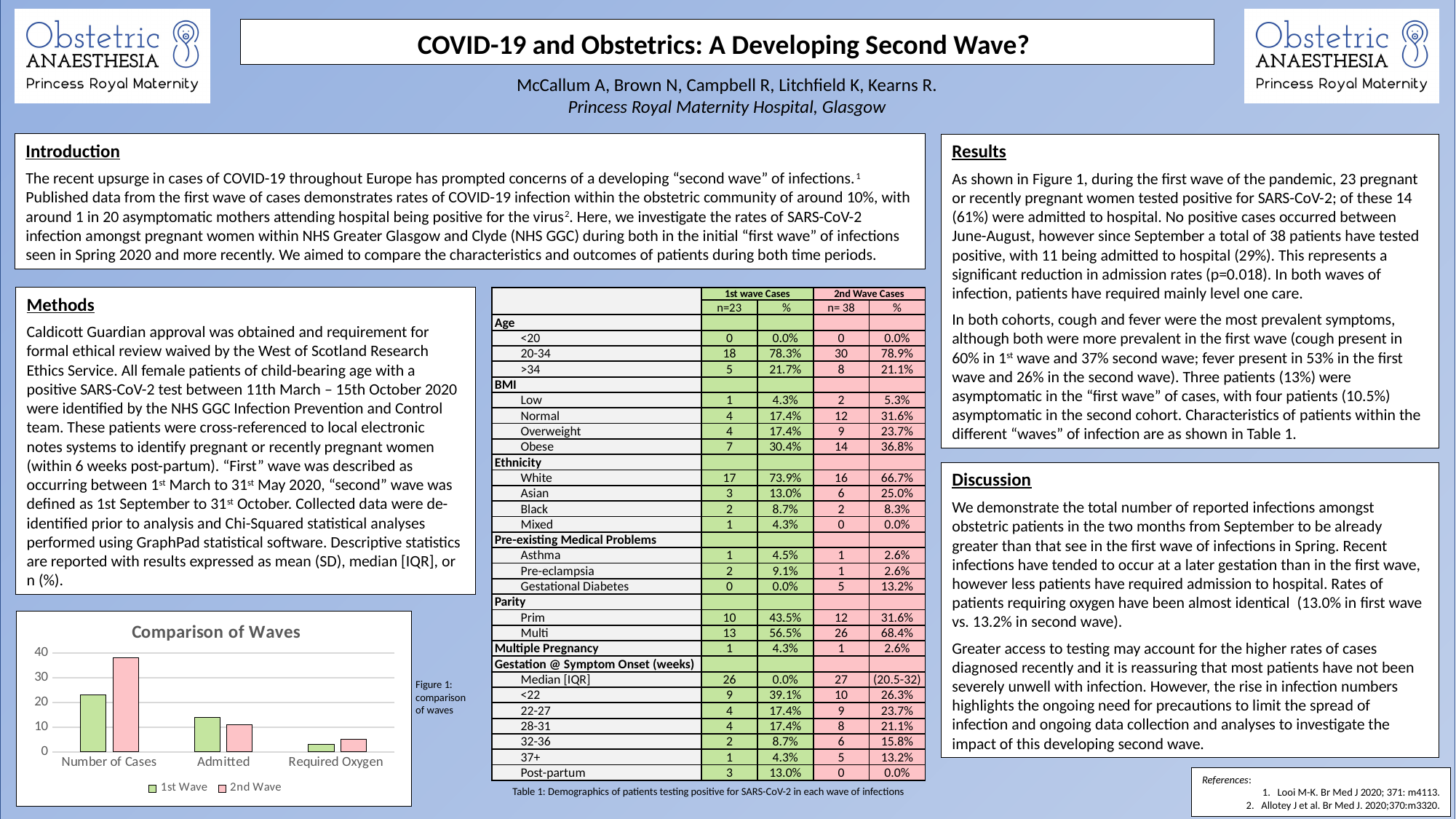
How many categories are shown on the x axis of the chart? 3 What is the title of the chart? Comparison of Waves For Number of Cases, which wave has the larger value? 2nd Wave Is the 2nd Wave value for Required Oxygen greater or less than 10? less Is the 2nd Wave value for Number of Cases greater or less than 30? greater How many series does the chart's legend list? 2 What kind of chart is shown on the slide? Bar chart Which series is shown in pink in the chart? 2nd Wave Which category has the tallest bar in the chart? Number of Cases Is the 1st Wave value for Admitted greater or less than 10? greater For Admitted, which wave has the larger value? 1st Wave